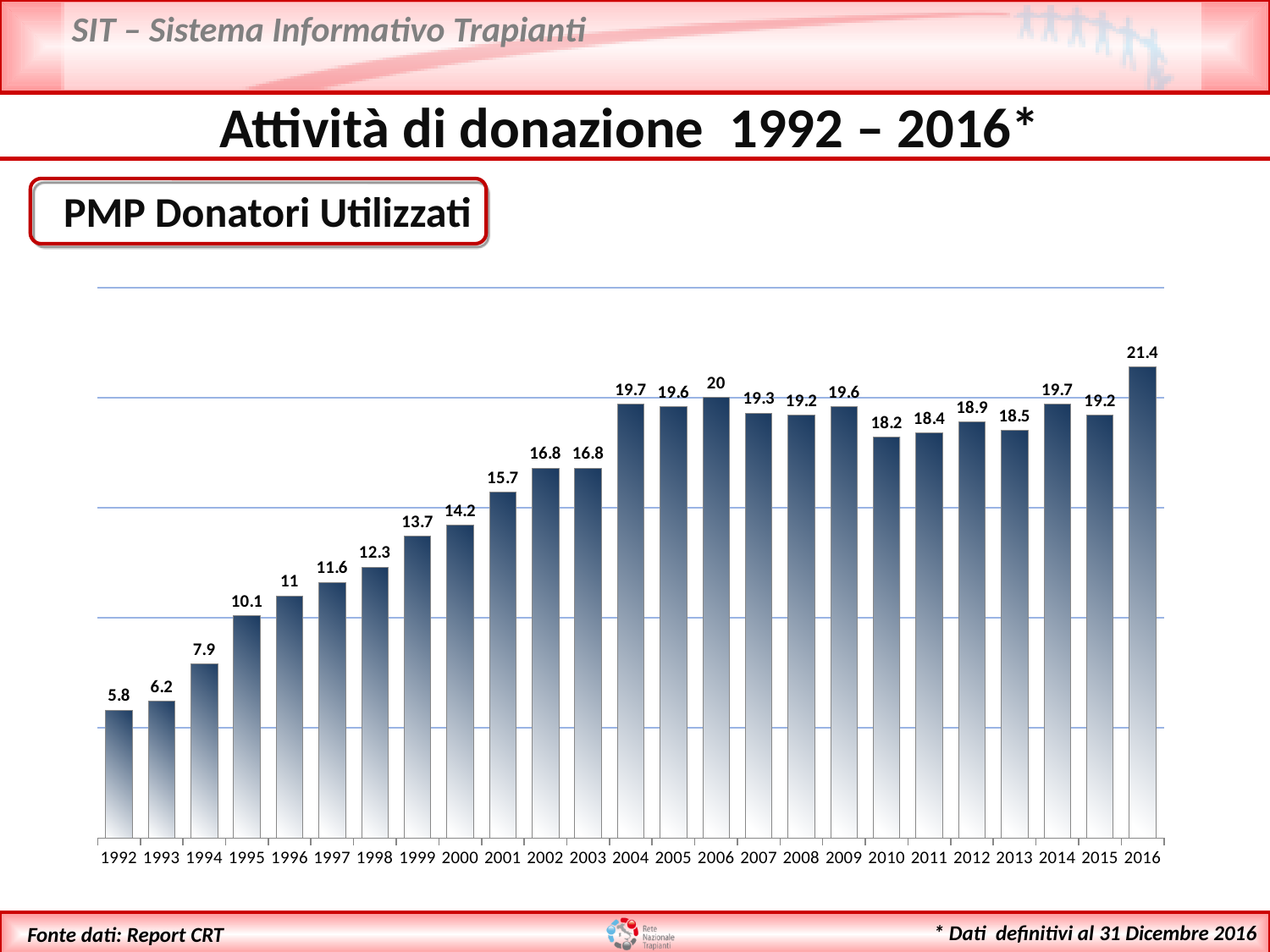
How many years are shown on the x axis? 25 What is the difference between the values for 2016 and 1992? 15.6 What is the value shown for 2006? 20 Do the values generally rise or fall from 1992 to 2004? Rise What is the value shown for 2010? 18.2 What is the difference between the values for 2006 and 2010? 1.8 What kind of chart is shown on the slide? Bar chart What is the value shown for 1992? 5.8 Which year has the lowest value? 1992 Which is larger, the value for 2004 or the value for 2013? 2004 What is the PMP Donatori Utilizzati value for 2016? 21.4 Which year has the highest value? 2016